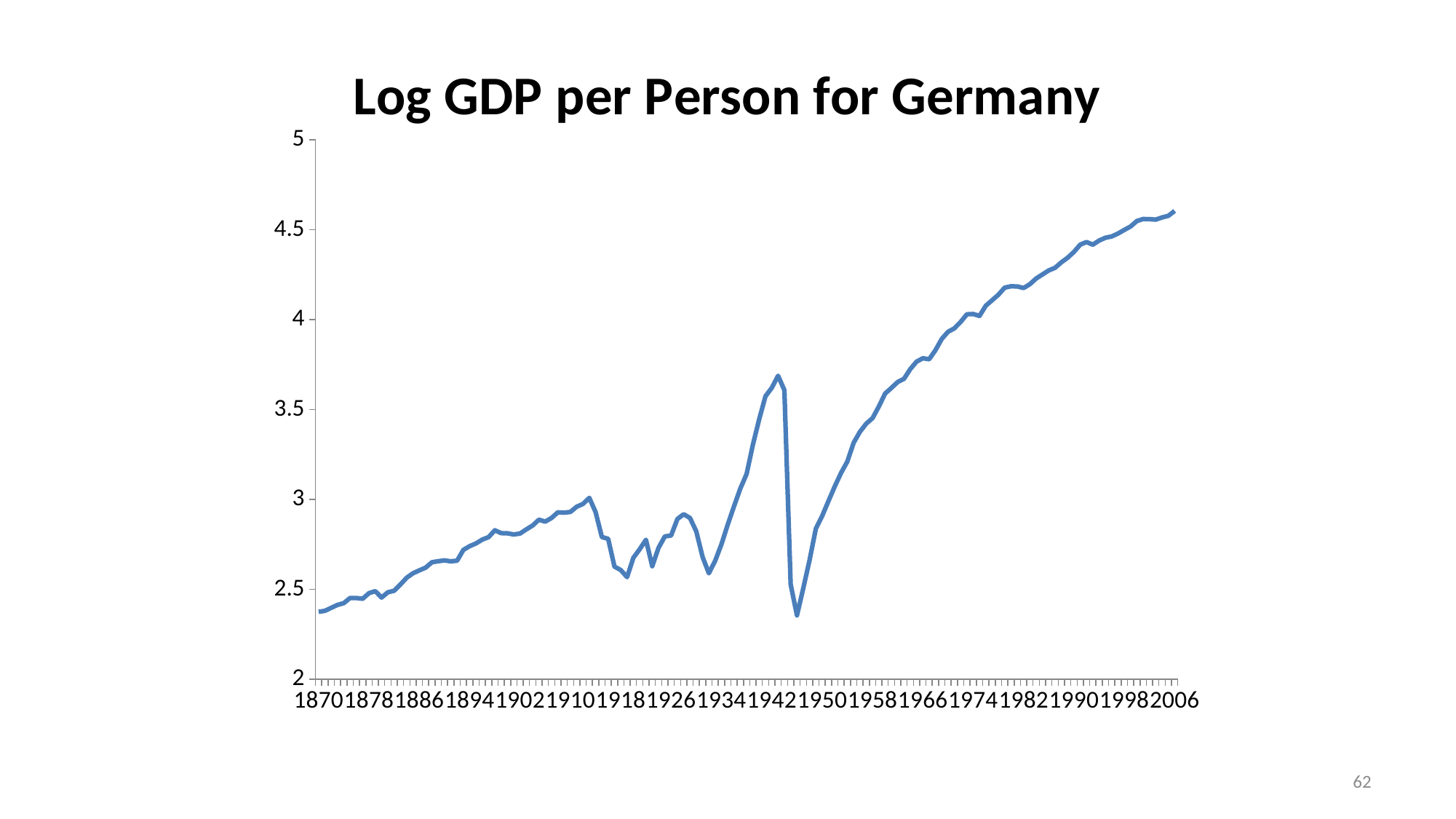
Is the value for 1934 greater or less than 3? less Which year has the larger value, 1870 or 2006? 2006 What kind of chart is shown on the slide? line chart Which year has the larger value, 1942 or 1946? 1942 Is the value for 1870 greater or less than 2.5? less Is the value for 2006 greater or less than 4.5? greater Overall, does the line rise or fall from 1870 to 2006? rise How many year labels are shown on the x axis? 18 What is the title of the chart? Log GDP per Person for Germany In which year shown on the x axis does the line reach its highest value? 2006